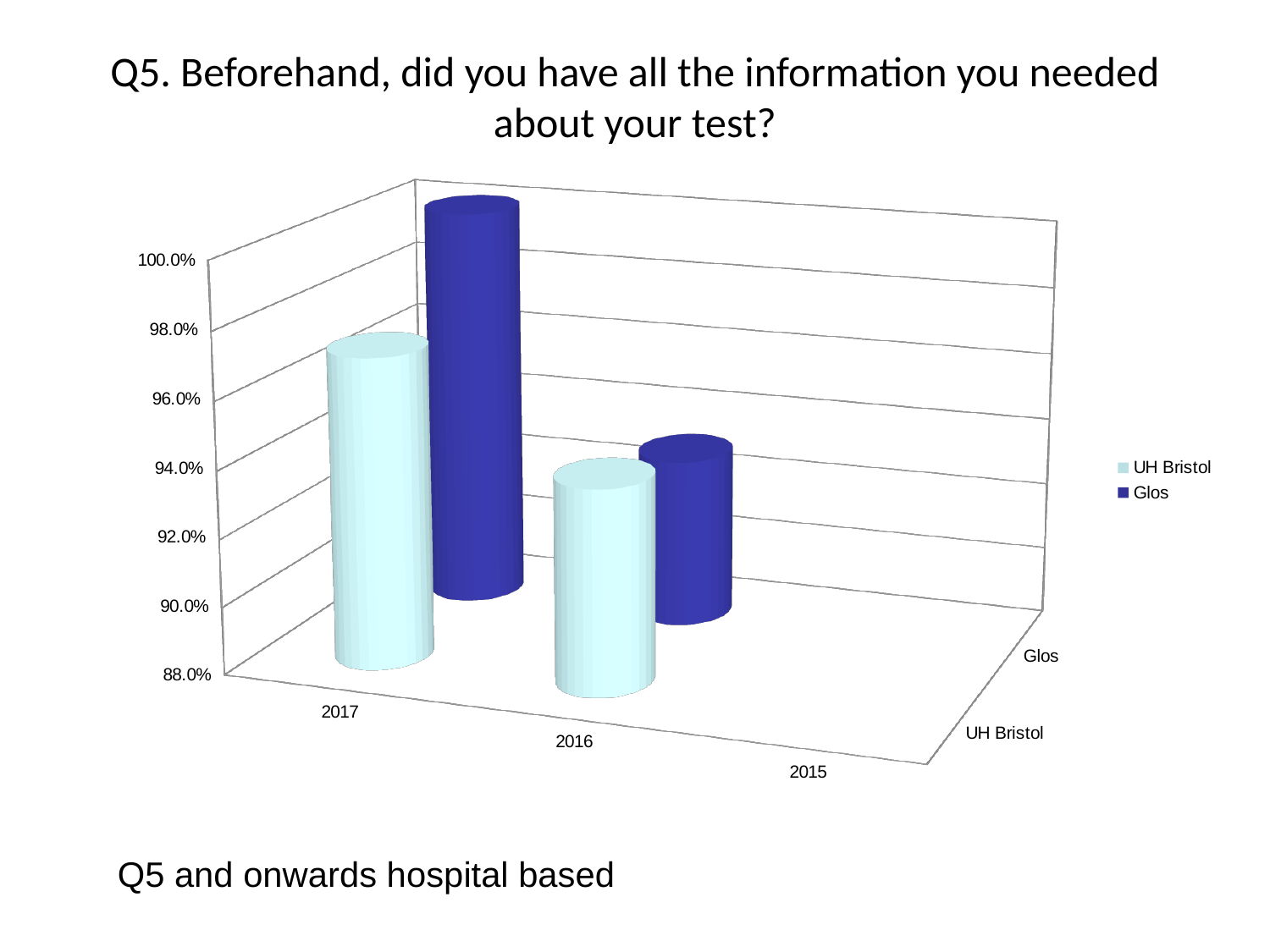
Which series has the tallest bar in 2017, UH Bristol or Glos? Glos How many series does the legend list? 2 In which year is the Glos bar highest? 2017 What kind of chart is shown on the slide? bar chart In which year is the UH Bristol bar highest? 2017 Do the Glos values rise or fall from 2016 to 2017? rise Is the UH Bristol value for 2016 greater or less than 96.0%? less How many years are labelled on the x axis? 3 Is the Glos value for 2017 greater or less than 96.0%? greater What are the two entries in the chart legend? UH Bristol and Glos Is the Glos value for 2016 greater or less than 96.0%? less